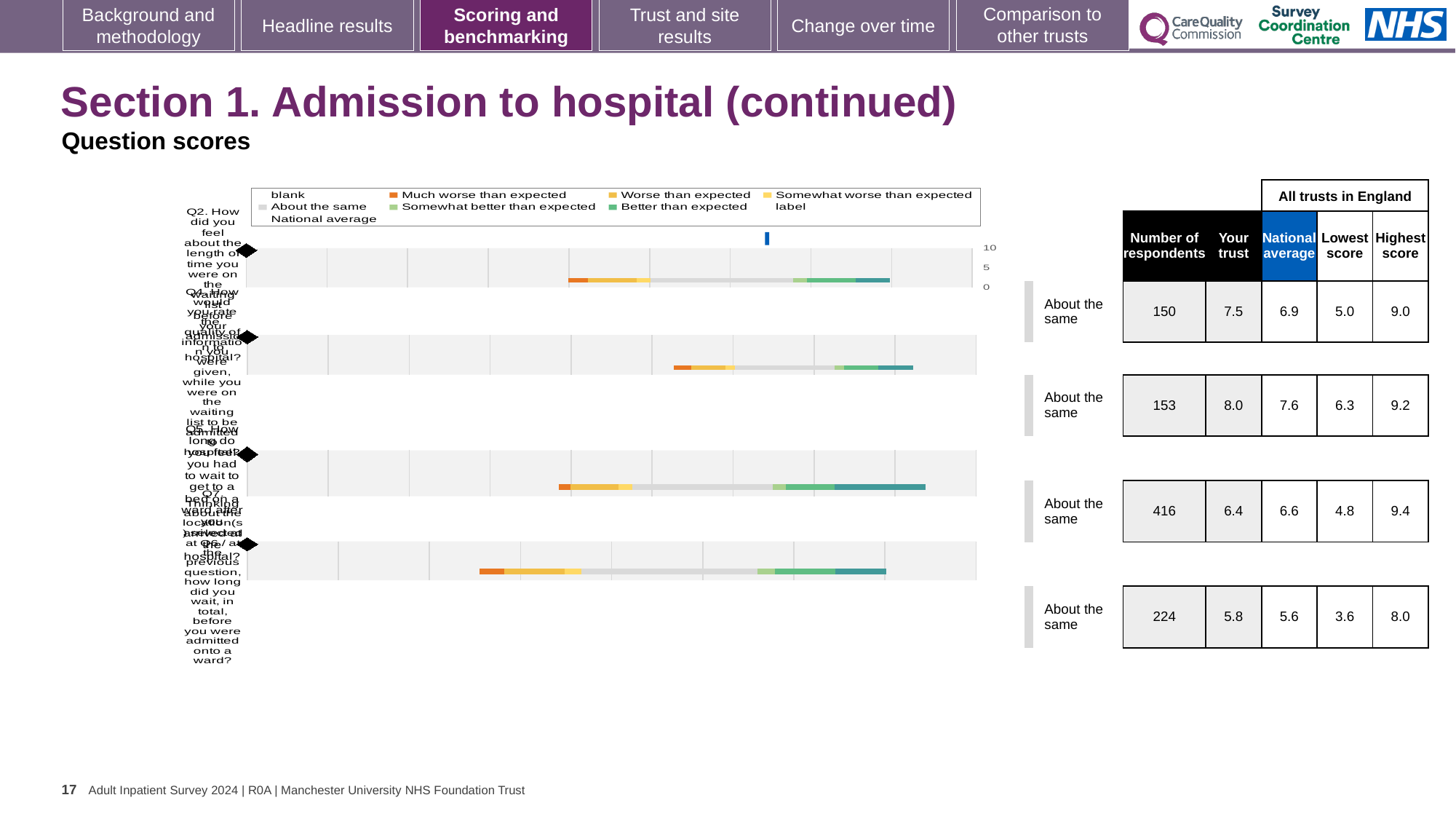
In the table, what is the 'Your trust' score for the row with 416 respondents? 6.4 What benchmark category is shown next to each of the four question rows? About the same How many question rows are shown in the chart and table? 4 In the first row of the table, what is the difference between the 'Your trust' score and the national average? 0.6 In the second row of the table, which is larger: the 'Your trust' score or the national average? Your trust (8.0) In the table, what is the national average for the row with 153 respondents? 7.6 What kind of chart is used to show the question scores? Bar chart Which row of the table has the largest number of respondents? The third row (416 respondents) In the table, how many respondents are listed for the first question row (Q2)? 150 In the table, what is the highest score for the row with 224 respondents? 8.0 In the table, what is the lowest score for the first question row (Q2)? 5.0 Which row of the table has the smallest 'Lowest score' value? The fourth row (3.6)